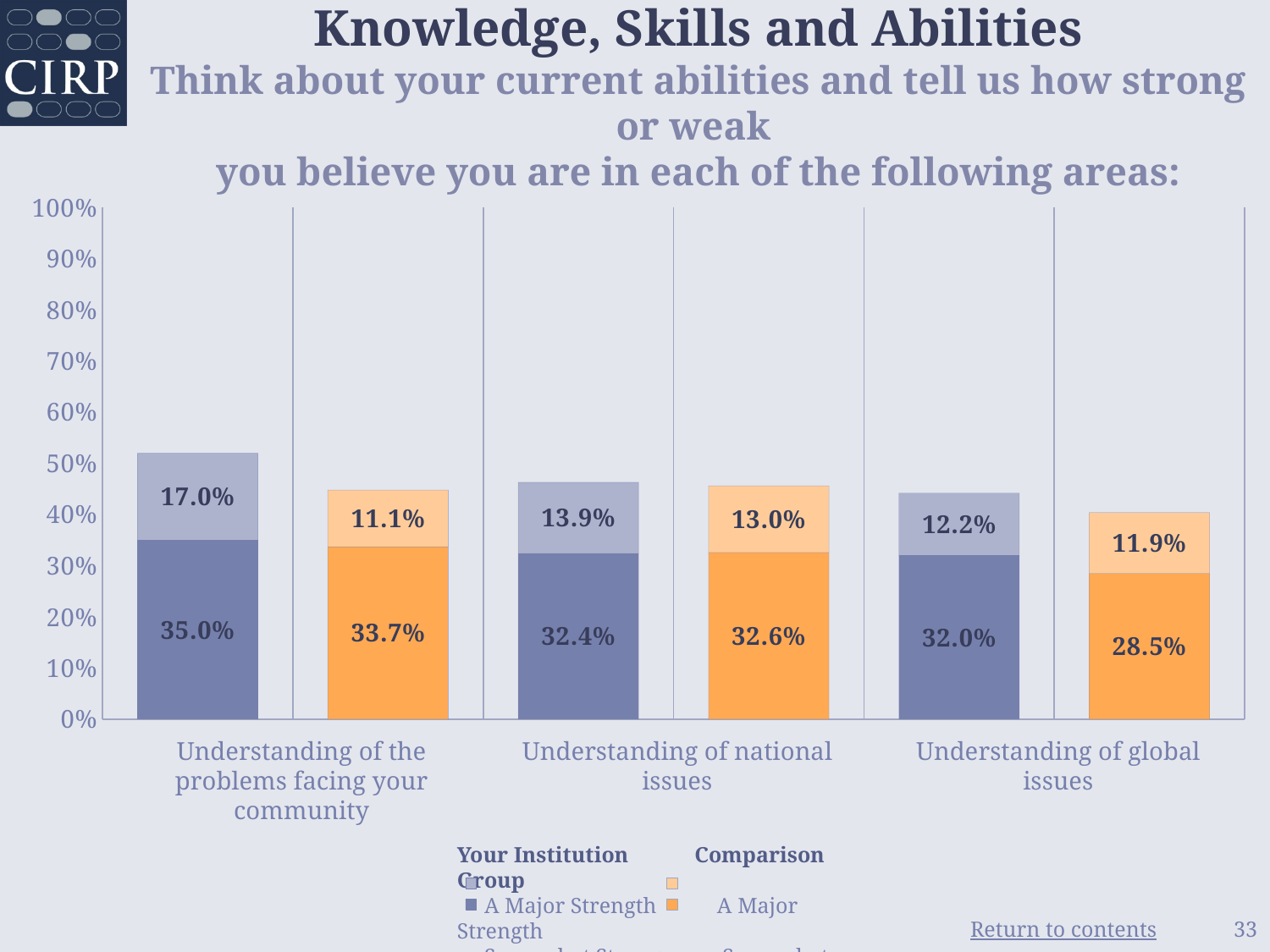
What is the value of the lighter (upper) segment for Your Institution for 'Understanding of national issues'? 13.9% What is the 'A Major Strength' value for Your Institution for 'Understanding of the problems facing your community'? 35.0% Which category has the highest 'A Major Strength' value for Your Institution? Understanding of the problems facing your community What is the difference between the 'A Major Strength' values for Your Institution and the Comparison Group for 'Understanding of global issues'? 3.5% What is the 'A Major Strength' value for the Comparison Group for 'Understanding of global issues'? 28.5% How many categories are shown along the x axis? 3 Is the total height of the Comparison Group bar for 'Understanding of global issues' greater or less than 50%? less What is the value of the lighter (upper) segment for the Comparison Group for 'Understanding of the problems facing your community'? 11.1% For 'Understanding of the problems facing your community', which is larger: the upper segment for Your Institution or the upper segment for the Comparison Group? Your Institution Which category has the lowest 'A Major Strength' value for the Comparison Group? Understanding of global issues What is the total height of the Your Institution stacked bar for 'Understanding of the problems facing your community'? 52.0% What kind of chart is shown on the slide? stacked bar chart